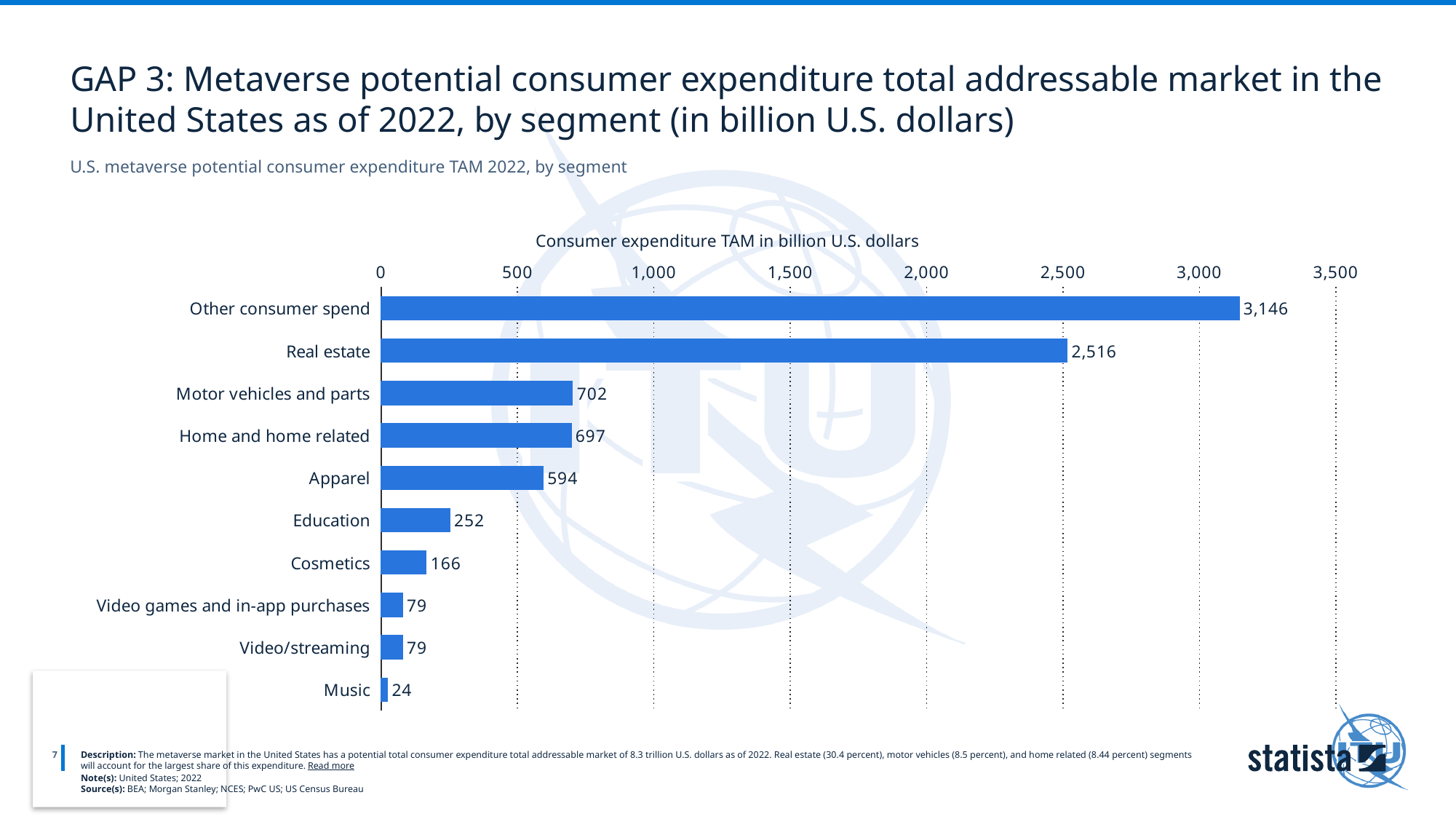
Is the value for Real estate greater or less than 2,000? greater Which segment has the lowest consumer expenditure TAM? Music What is the consumer expenditure TAM for Education? 252 What is the difference between the values for Motor vehicles and parts and Home and home related? 5 How many segments are shown in the chart? 10 What kind of chart is shown on the slide? Bar chart What is the difference between the values for Other consumer spend and Real estate? 630 What is the consumer expenditure TAM for Cosmetics? 166 Which segment has the highest consumer expenditure TAM? Other consumer spend What is the axis title shown above the chart? Consumer expenditure TAM in billion U.S. dollars Which is larger, the value for Apparel or the value for Education? Apparel What is the consumer expenditure TAM for Real estate? 2,516